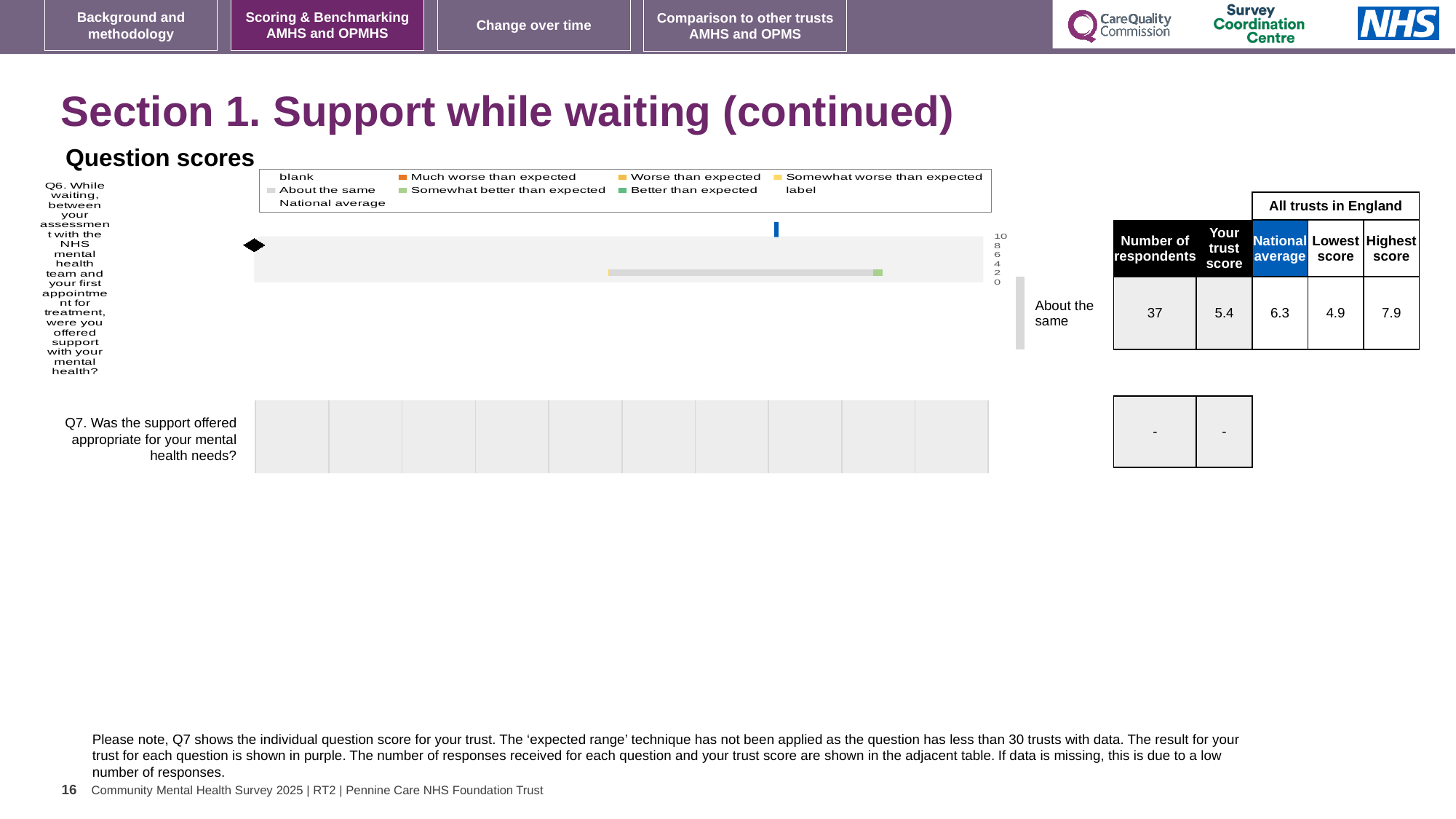
What kind of chart is used to show the Q6 question score? bar chart What is the highest tick value shown on the chart's score axis? 10 What is the trust score for Q6 shown in the table next to the chart? 5.4 What value is shown for the number of respondents for Q7? - Which is larger for Q6, the trust score or the national average? National average What category label is shown for the Q6 result? About the same How many respondents answered Q6? 37 What is the national average score for Q6? 6.3 What is the highest score among all trusts in England for Q6? 7.9 How many questions are plotted on the chart? 2 What is the difference between the national average and the trust score for Q6? 0.9 What is the lowest score among all trusts in England for Q6? 4.9